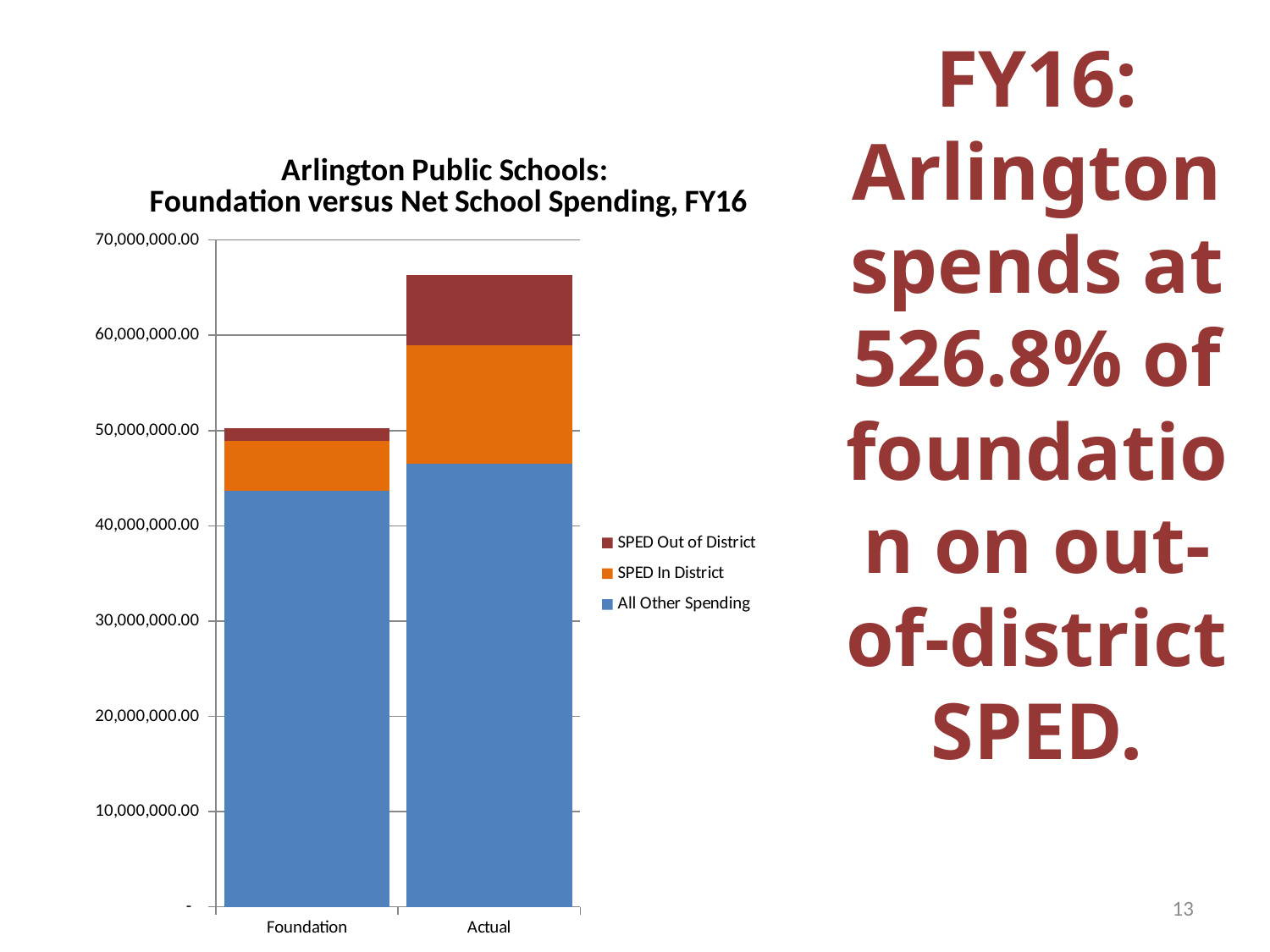
How many categories are shown on the x axis of the chart? 2 What is the title of the chart? Arlington Public Schools: Foundation versus Net School Spending, FY16 Which series is shown in blue in the chart? All Other Spending Is the SPED Out of District segment larger for Foundation or for Actual? Actual What kind of chart is shown on the slide? stacked bar chart Is the All Other Spending value for Foundation greater or less than 40,000,000.00? greater Is the total value of the Actual bar greater or less than 70,000,000.00? less How many series does the chart's legend list? 3 Which bar is taller overall, Foundation or Actual? Actual Is the total value of the Actual bar greater or less than 60,000,000.00? greater Which category has the highest total spending? Actual Which category has the lowest total spending? Foundation